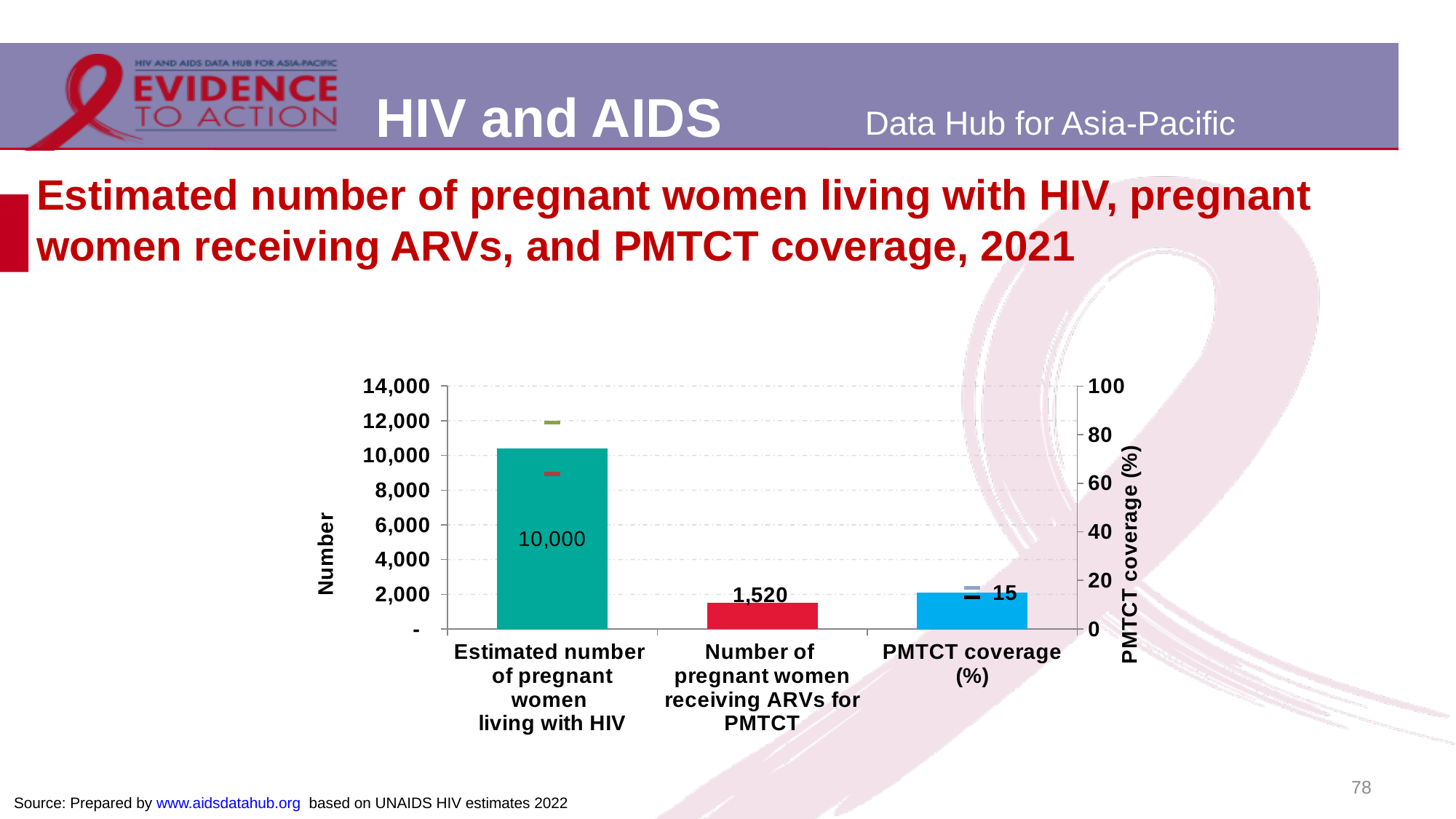
What is the estimated number of pregnant women living with HIV shown on the chart? 10,000 What is the PMTCT coverage (%) value shown on the chart? 15 What is the label of the left vertical axis of the chart? Number Which is larger: the estimated number of pregnant women living with HIV or the number of pregnant women receiving ARVs for PMTCT? Estimated number of pregnant women living with HIV Is the PMTCT coverage (%) value greater or less than 20 on the right-hand axis? less What is the label of the right vertical axis of the chart? PMTCT coverage (%) Is the number of pregnant women receiving ARVs for PMTCT greater or less than 2,000? less What type of chart is shown on the slide? Bar chart What is the number of pregnant women receiving ARVs for PMTCT shown on the chart? 1,520 Which category has the tallest bar on the chart? Estimated number of pregnant women living with HIV How many bars are plotted on the chart? 3 What is the difference between the estimated number of pregnant women living with HIV and the number of pregnant women receiving ARVs for PMTCT? 8,480